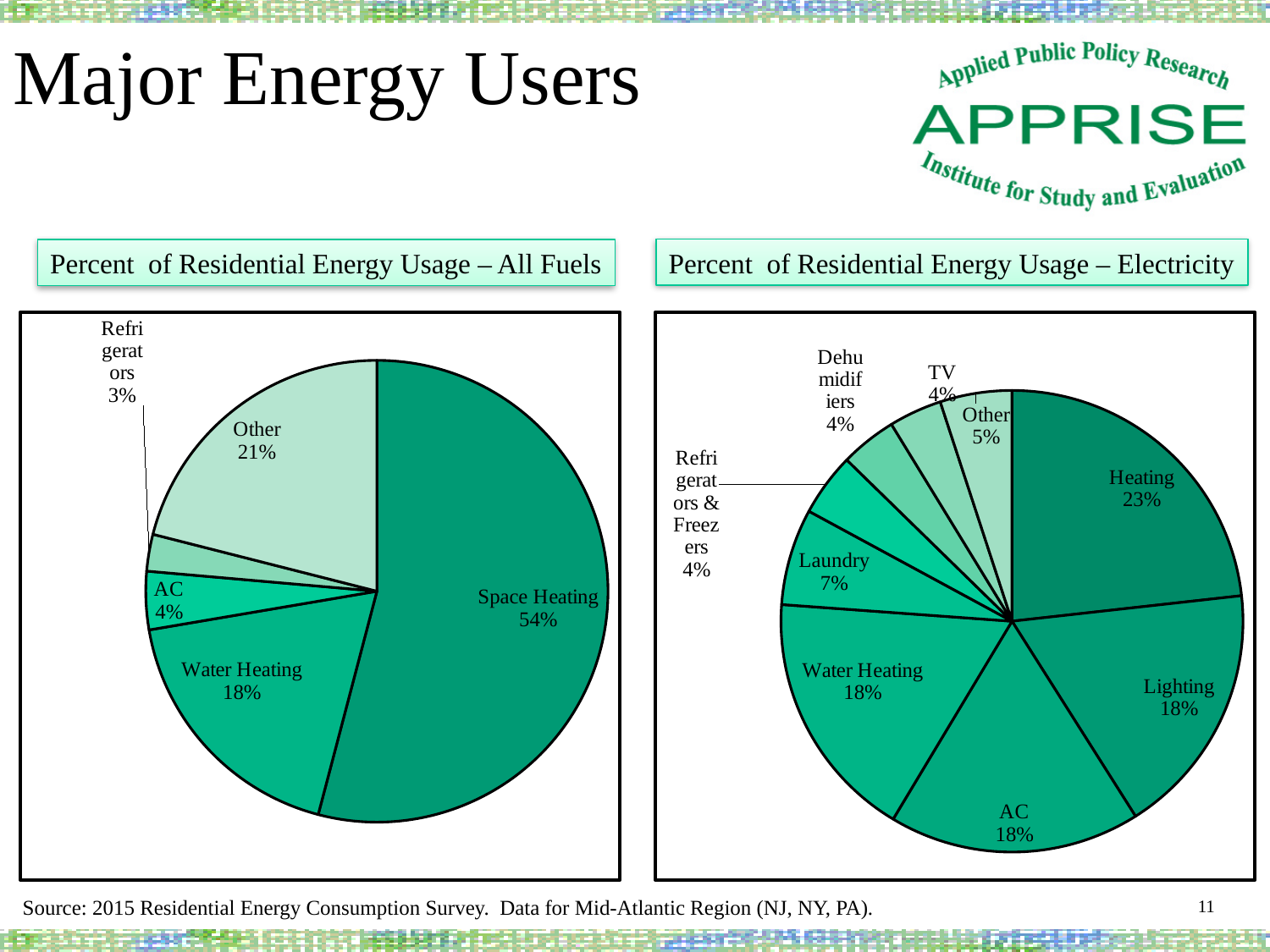
In the 'Percent of Residential Energy Usage – Electricity' chart, which is larger, Lighting or Laundry? Lighting In the 'Percent of Residential Energy Usage – All Fuels' chart, what share does Space Heating have? 54% In the 'Percent of Residential Energy Usage – Electricity' chart, what share does Laundry have? 7% In the 'Percent of Residential Energy Usage – Electricity' chart, what share does Heating have? 23% In the 'Percent of Residential Energy Usage – All Fuels' chart, what is the difference between the Other share and the AC share? 17% What kind of chart is used on the left side of the slide for 'Percent of Residential Energy Usage – All Fuels'? Pie chart In the 'Percent of Residential Energy Usage – All Fuels' chart, how many slices does the pie have? 5 In the 'Percent of Residential Energy Usage – Electricity' chart, which category has the largest share? Heating In the 'Percent of Residential Energy Usage – Electricity' chart, what is the difference between the Heating share and the Other share? 18% In the 'Percent of Residential Energy Usage – All Fuels' chart, what share does Water Heating have? 18% In the 'Percent of Residential Energy Usage – Electricity' chart, how many slices does the pie have? 9 In the 'Percent of Residential Energy Usage – All Fuels' chart, which category has the smallest share? Refrigerators